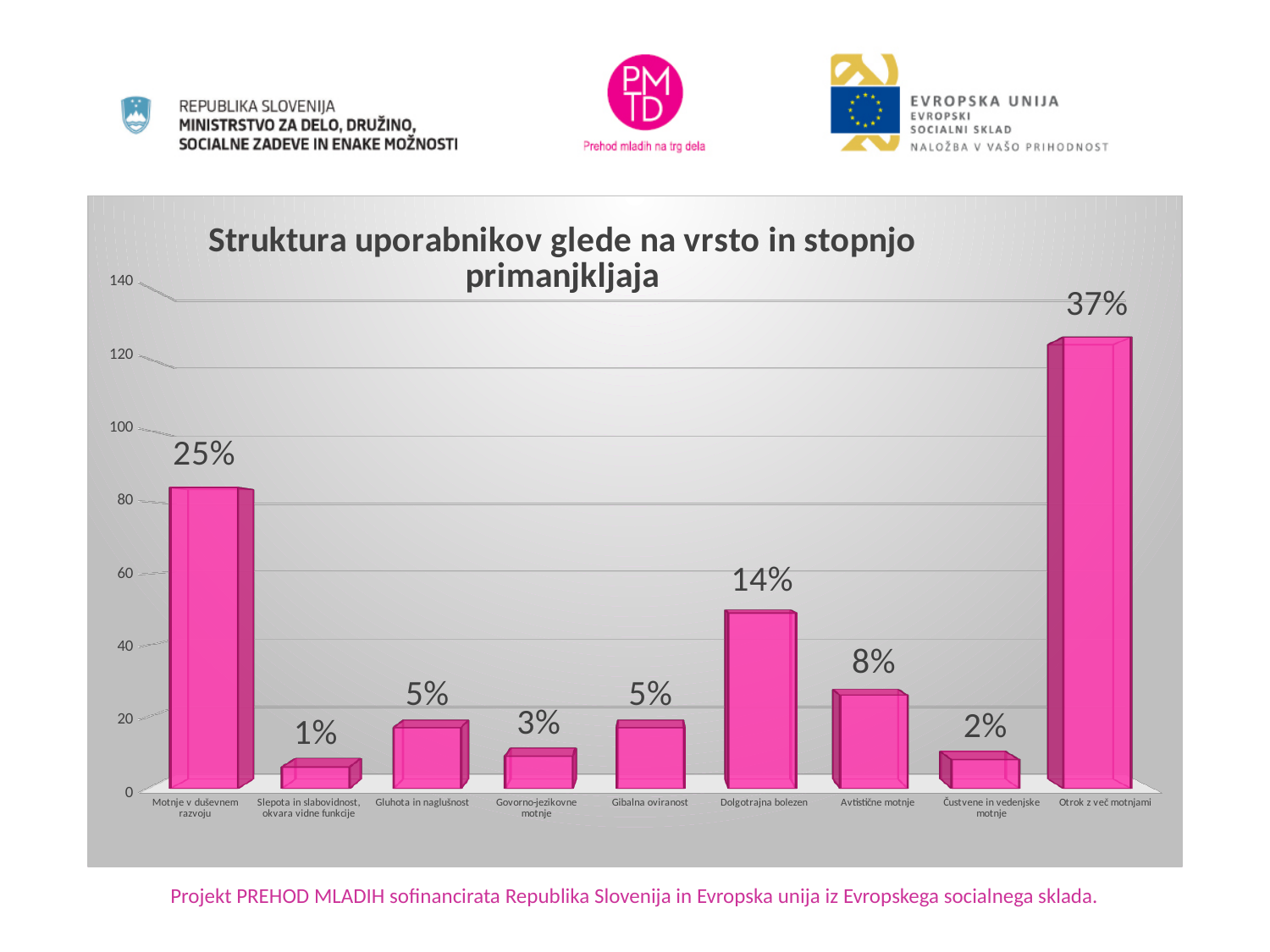
What percentage is labelled for Govorno-jezikovne motnje? 3% What percentage is labelled for Avtistične motnje? 8% What is the difference in percentage points between Otrok z več motnjami and Motnje v duševnem razvoju? 12% Which category has the lowest value? Slepota in slabovidnost, okvara vidne funkcije What percentage is labelled for Dolgotrajna bolezen? 14% Is the bar for Otrok z več motnjami greater or less than 100 on the y axis? greater Which category has the highest value? Otrok z več motnjami What is the title of the chart? Struktura uporabnikov glede na vrsto in stopnjo primanjkljaja What percentage is labelled for Motnje v duševnem razvoju? 25% What percentage is labelled for Otrok z več motnjami? 37% How many categories are shown on the x axis of the chart? 9 What kind of chart is shown on the slide? bar chart